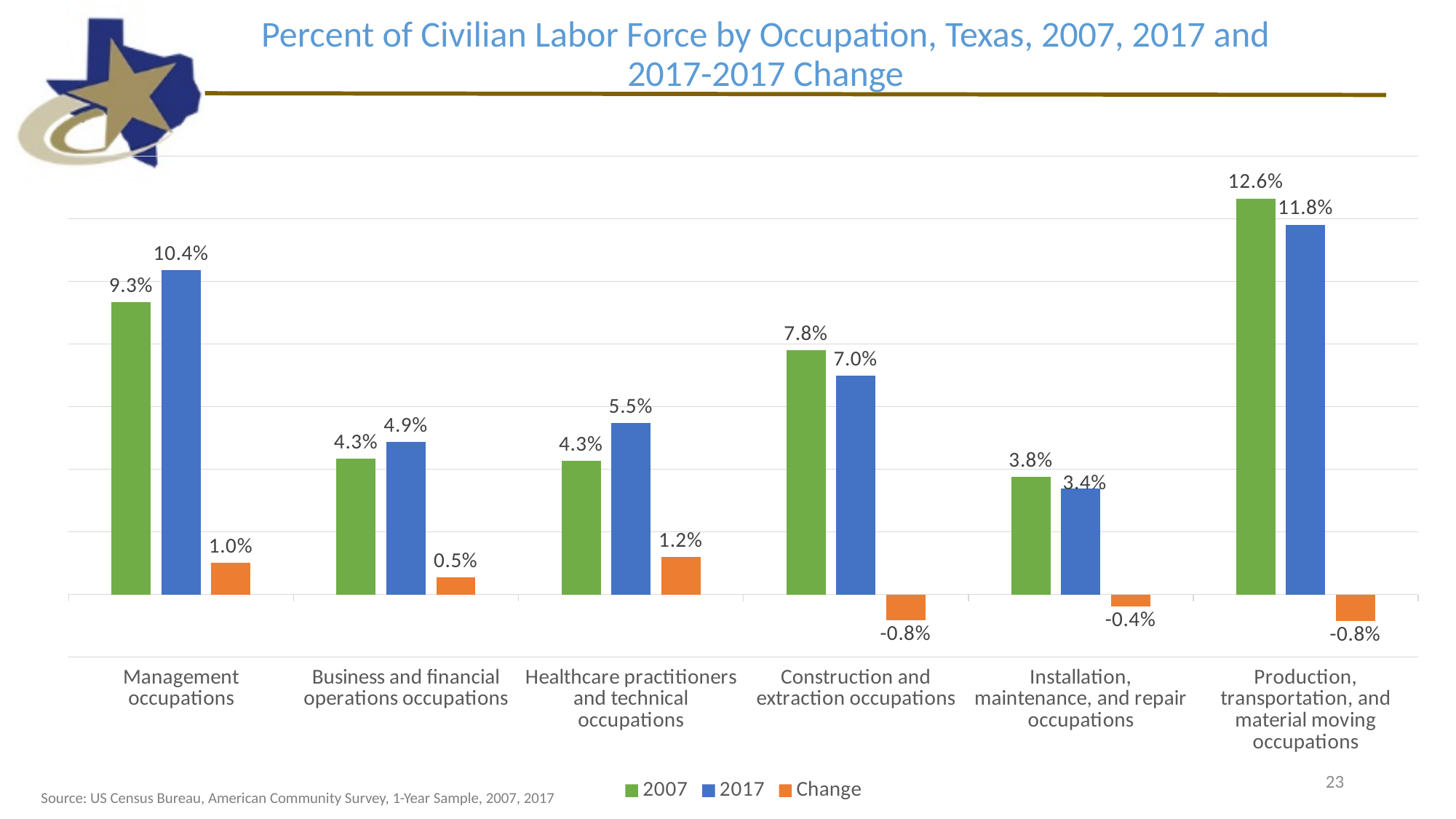
How many series does the legend list? 3 What is the Change value for Healthcare practitioners and technical occupations? 1.2% Which series is shown in orange in the legend? Change Which is larger for Business and financial operations occupations, the 2007 value or the 2017 value? 2017 Which occupation category has the highest 2007 value? Production, transportation, and material moving occupations What was the 2007 value for Construction and extraction occupations? 7.8% What is the Change value for Installation, maintenance, and repair occupations? -0.4% How many occupation categories are shown on the x axis? 6 What kind of chart is shown on the slide? Bar chart What is the difference between the 2007 and 2017 values for Production, transportation, and material moving occupations? 0.8% Which occupation category has the lowest 2017 value? Installation, maintenance, and repair occupations What was the 2017 value for Management occupations? 10.4%